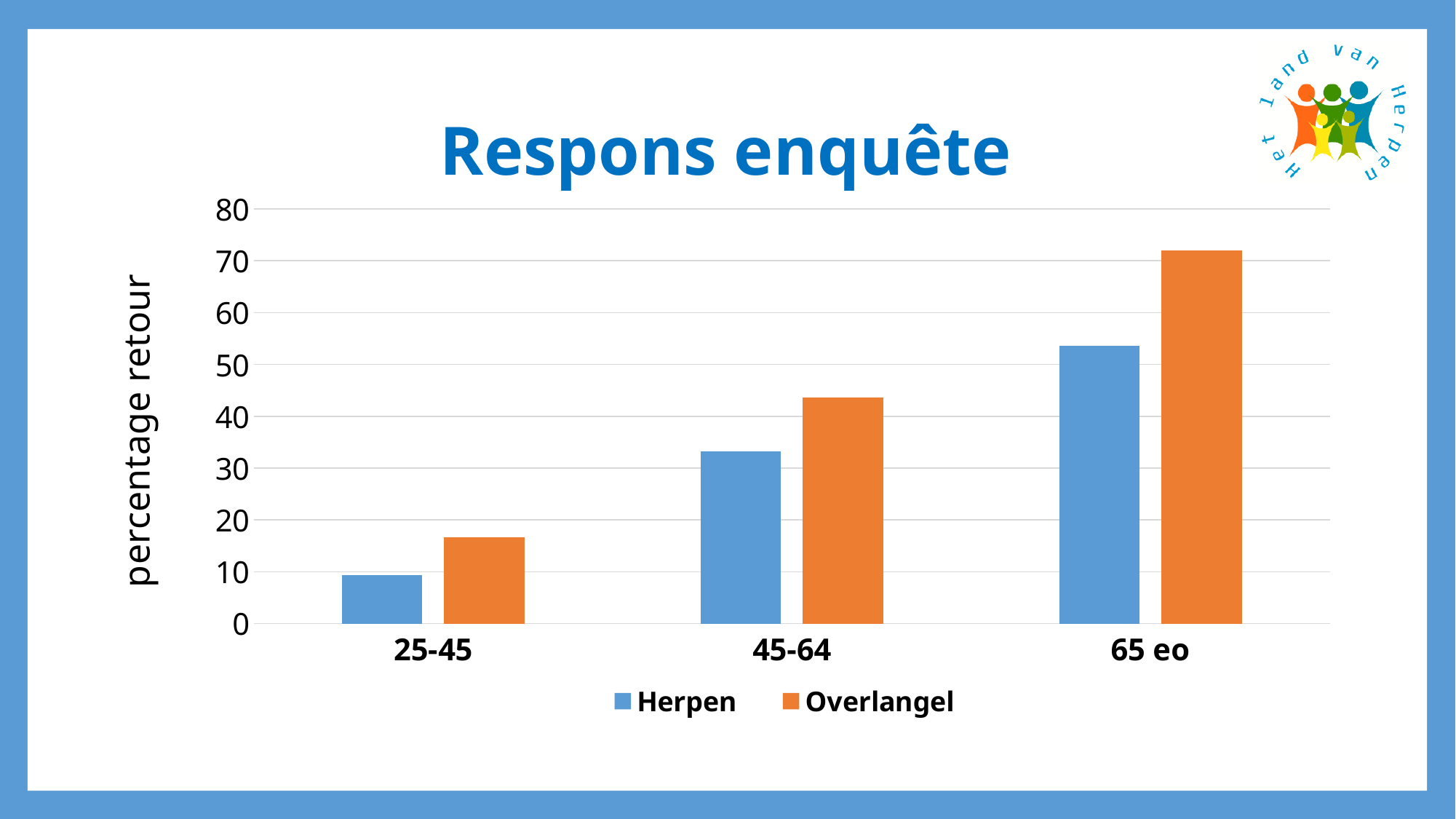
Which age category has the highest value for Overlangel? 65 eo What is the title of the chart? Respons enquête Is the value for Herpen in the 65 eo category greater or less than 50? greater Is the value for Overlangel in the 65 eo category greater or less than 70? greater Do the Herpen values rise or fall from the 25-45 category to the 65 eo category? rise Which age category has the lowest value for Herpen? 25-45 What is the label of the vertical axis? percentage retour How many series does the legend list? 2 For the 45-64 category, which is larger: Herpen or Overlangel? Overlangel What kind of chart is shown on the slide? bar chart How many age categories are shown on the x axis? 3